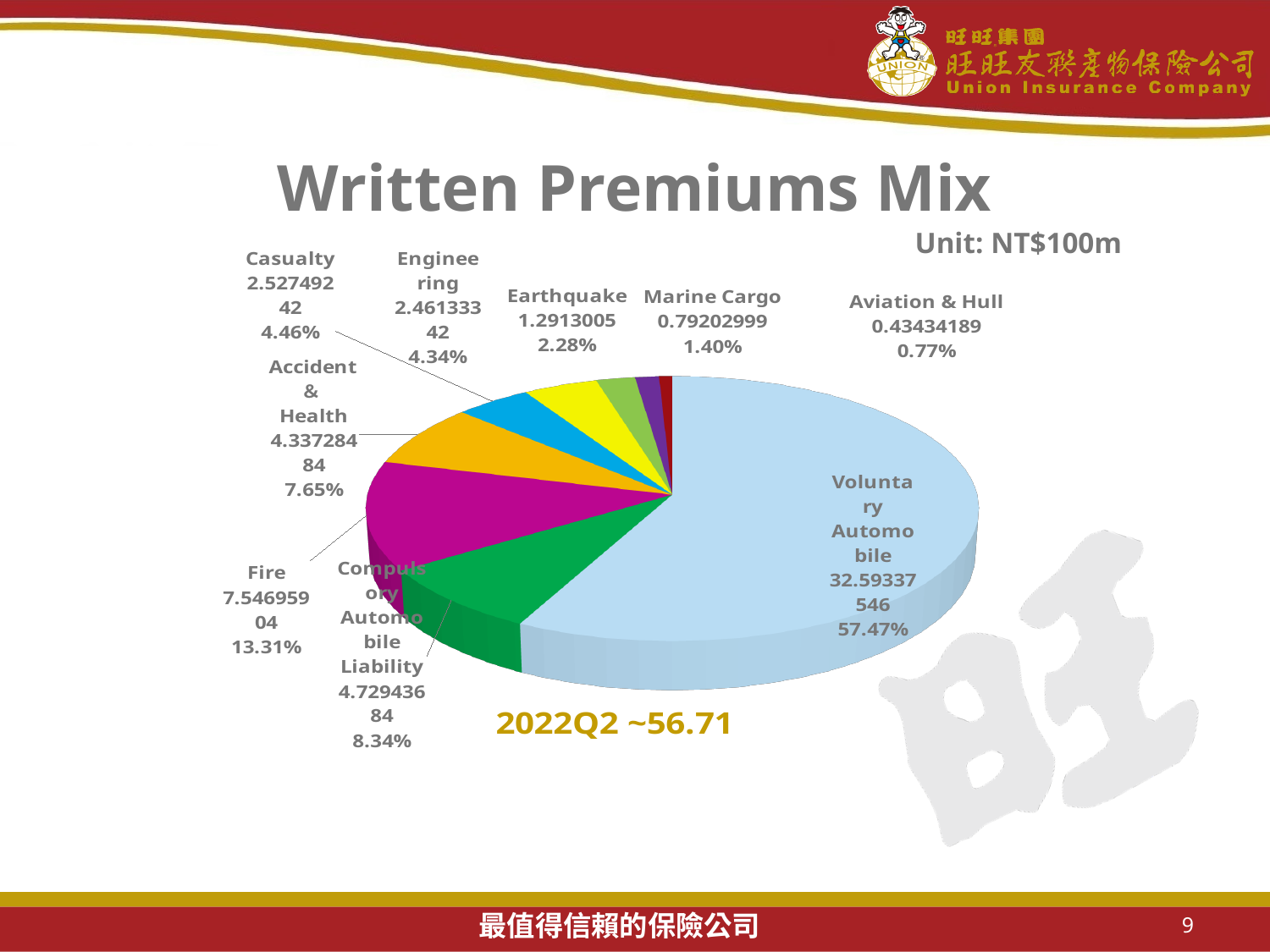
What is the value shown for Aviation & Hull? 0.43434189 Which category has the smallest slice of the pie? Aviation & Hull What is the value shown for Earthquake? 1.2913005 What unit is stated for the chart values? NT$100m What share of the pie does Fire account for? 13.31% How many categories (slices) does the pie chart show? 9 What is the title of the chart? 2022Q2 ~56.71 What kind of chart is shown on the slide? Pie chart Which category has the largest slice of the pie? Voluntary Automobile What percentage is shown for Compulsory Automobile Liability? 8.34% Which is larger, the share for Accident & Health or the share for Casualty? Accident & Health What share of the pie does Voluntary Automobile account for? 57.47%